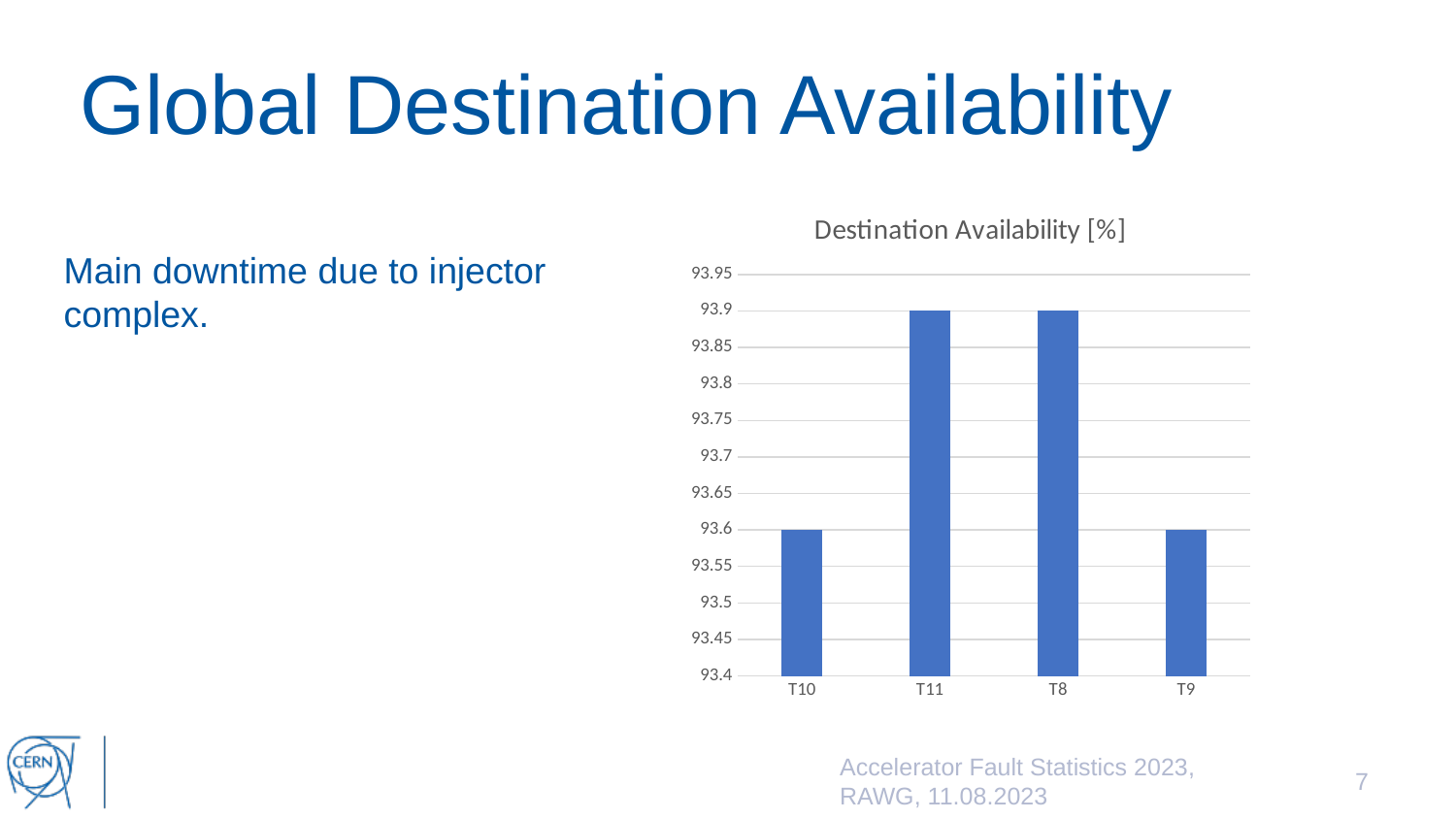
What is the destination availability value for T9? 93.6 What is the title of the chart? Destination Availability [%] What type of chart is shown on the slide? bar chart Is the value for T10 greater or less than 93.7? less What is the destination availability value for T10? 93.6 Is the value for T8 greater or less than 93.8? greater What is the difference between the values for T11 and T10? 0.3 How many categories are plotted in the chart? 4 What is the destination availability value for T8? 93.9 Which has a lower destination availability, T8 or T9? T9 Which has a higher destination availability, T11 or T10? T11 What is the destination availability value for T11? 93.9